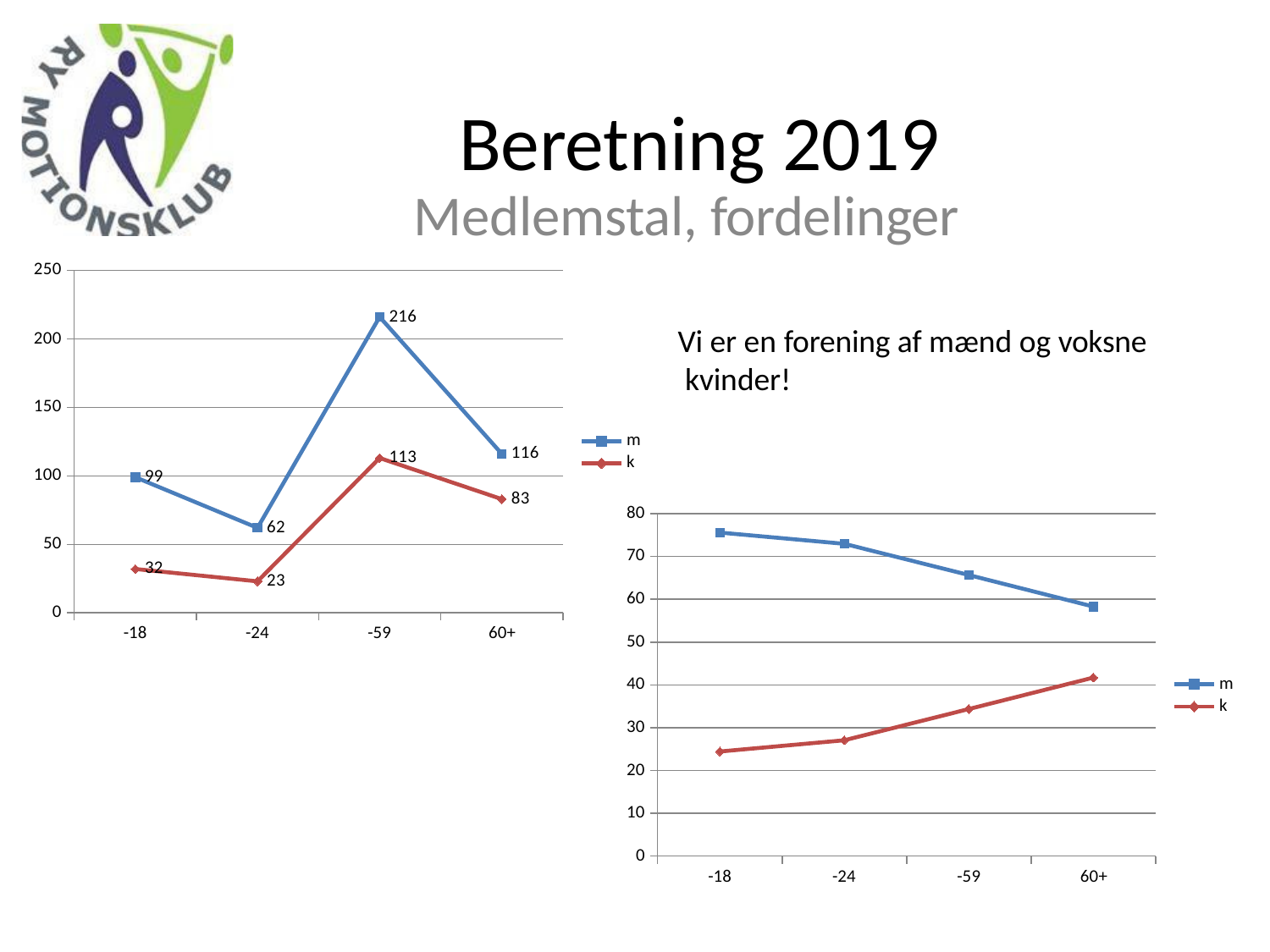
On the left chart, which category has the lowest value for series k? -24 On the right chart, is the value for series k at category 60+ greater or less than 50? less What kind of chart is the chart on the right? line chart On the left chart, what is the value for series k at category -24? 23 On the left chart, which category has the highest value for series m? -59 On the left chart, how many categories are shown on the x axis? 4 On the left chart, what is the difference between series m and series k at category 60+? 33 On the left chart, what is the value for series m at category -59? 216 On the right chart, is the value for series m at category -18 greater or less than 70? greater On the left chart, how many series does the legend list? 2 On the left chart, which is larger at category -18: series m or series k? m On the right chart, do the values for series k rise or fall from -18 to 60+? rise